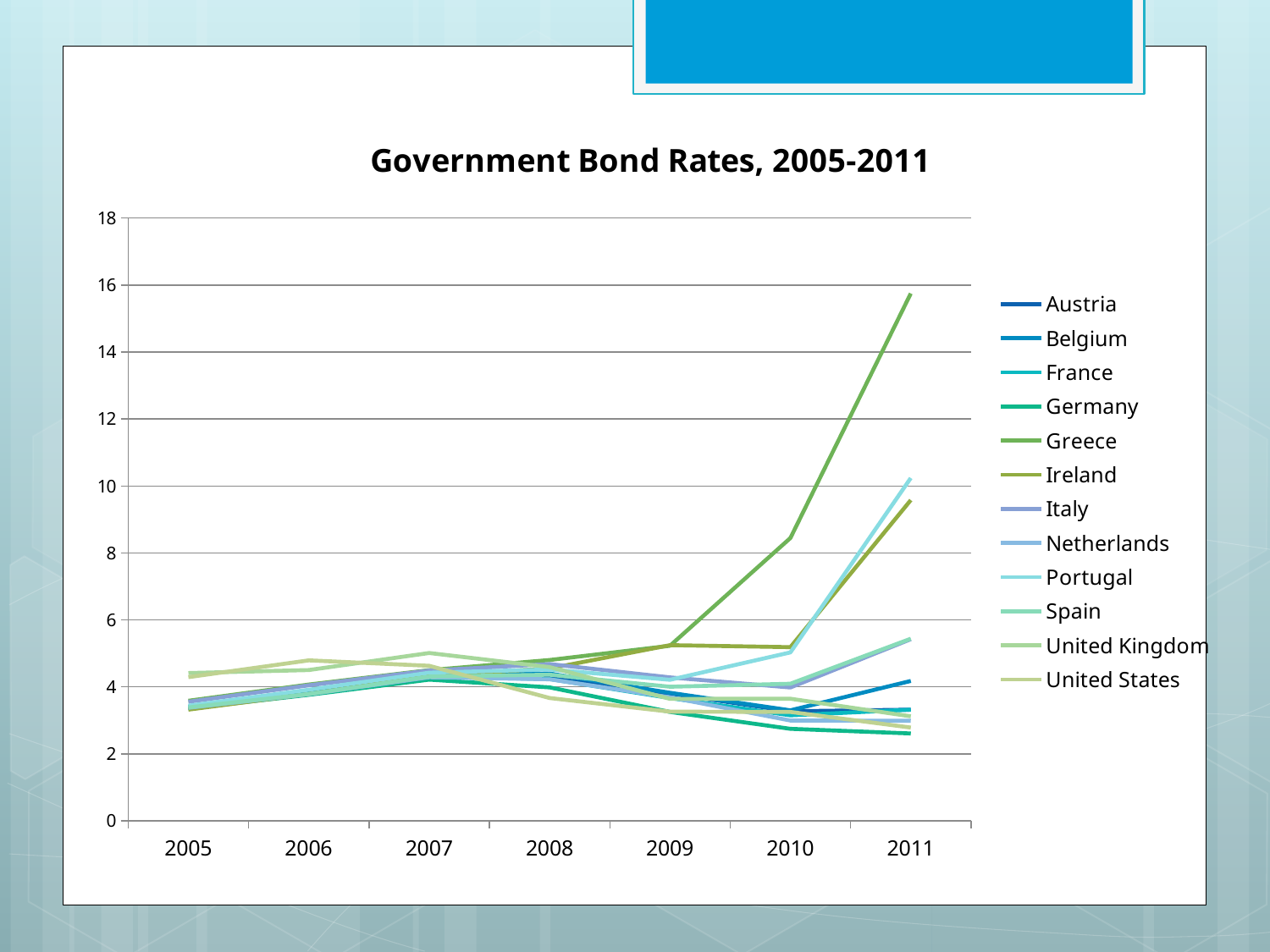
Is the value for Germany in 2011 greater or less than 4? less What is the title of the chart? Government Bond Rates, 2005-2011 Is the value for Portugal in 2011 greater or less than 8? greater Which country has the highest bond rate in 2011? Greece How many years are shown along the x axis? 7 Is the value for Ireland in 2011 greater or less than 8? greater Does the line for Greece rise or fall from 2009 to 2011? rise What kind of chart is shown on the slide? line chart How many series does the legend list? 12 Which is larger in 2011, the value for Greece or the value for Germany? Greece